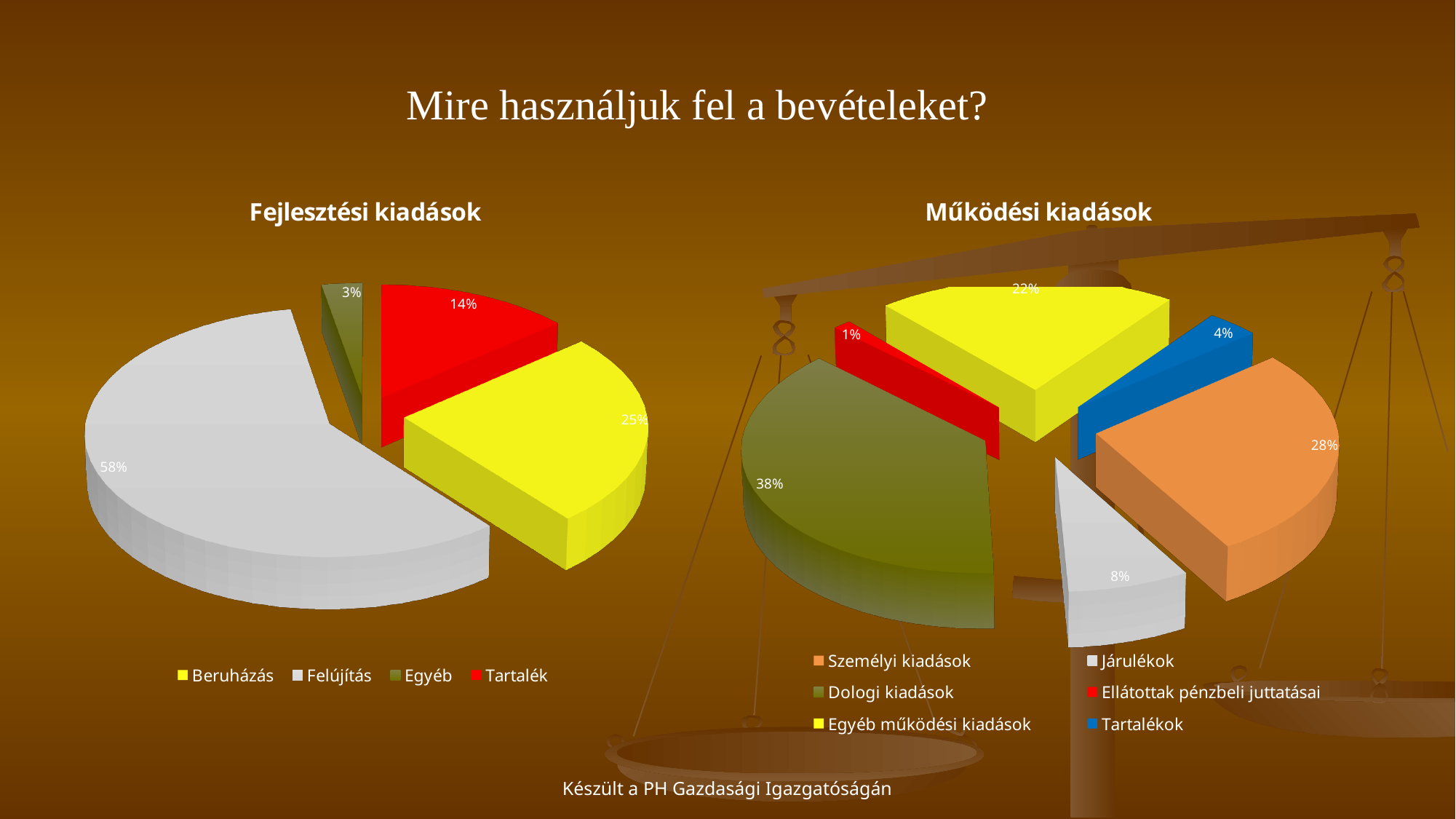
In the 'Működési kiadások' chart, which category has the smallest share? Ellátottak pénzbeli juttatásai In the 'Fejlesztési kiadások' chart, what is the difference between the shares of Beruházás and Tartalék? 11% In the 'Működési kiadások' chart, what share does Dologi kiadások have? 38% In the 'Fejlesztési kiadások' chart, what share does Tartalék have? 14% In the 'Működési kiadások' chart, which is larger: Személyi kiadások or Egyéb működési kiadások? Személyi kiadások How many categories does the legend of the 'Működési kiadások' chart list? 6 In the 'Fejlesztési kiadások' chart, which category has the largest share? Felújítás In the 'Fejlesztési kiadások' chart, what share does Felújítás have? 58% In the 'Működési kiadások' chart, what share does Járulékok have? 8% How many categories does the 'Fejlesztési kiadások' chart show? 4 In the 'Fejlesztési kiadások' chart, which category has the smallest share? Egyéb What type of chart is the 'Működési kiadások' chart? Pie chart